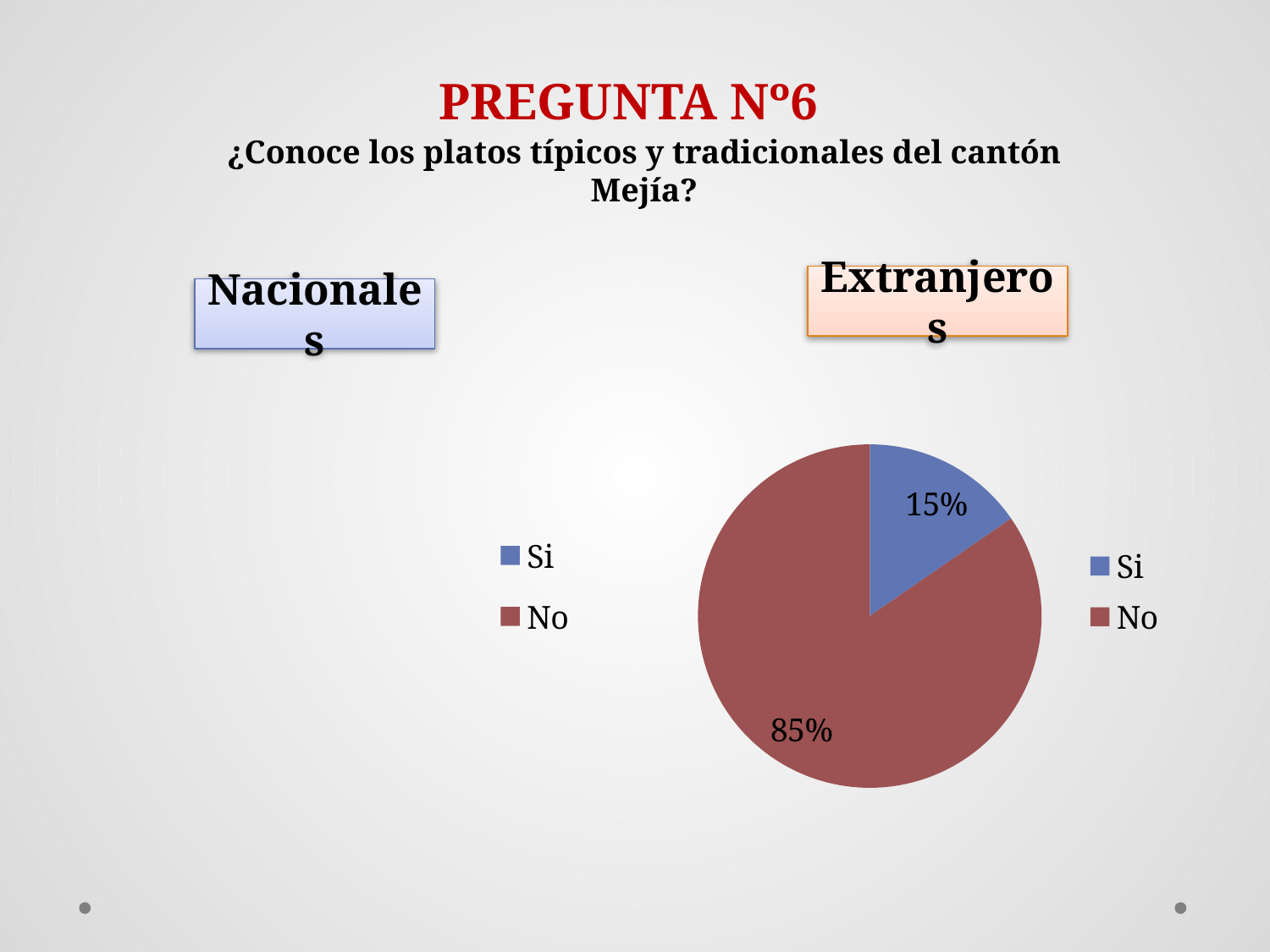
In the Extranjeros pie chart, what colour is the No slice? Red How many slices does the Extranjeros pie chart have? 2 How many entries does the legend of the Extranjeros chart list? 2 In the Extranjeros pie chart, what percentage answered Si? 15% In the Extranjeros pie chart, what is the difference in percentage points between No and Si? 70 In the Extranjeros pie chart, which answer has the largest slice? No In the Extranjeros pie chart, which is larger, the Si slice or the No slice? No In the Extranjeros pie chart, what percentage answered No? 85% What are the two legend entries shown for the Extranjeros chart? Si and No What kind of chart is shown under the Extranjeros heading? Pie chart In the Extranjeros pie chart, which answer has the smallest slice? Si In the Extranjeros pie chart, what share of the pie does the Si slice represent? 15%